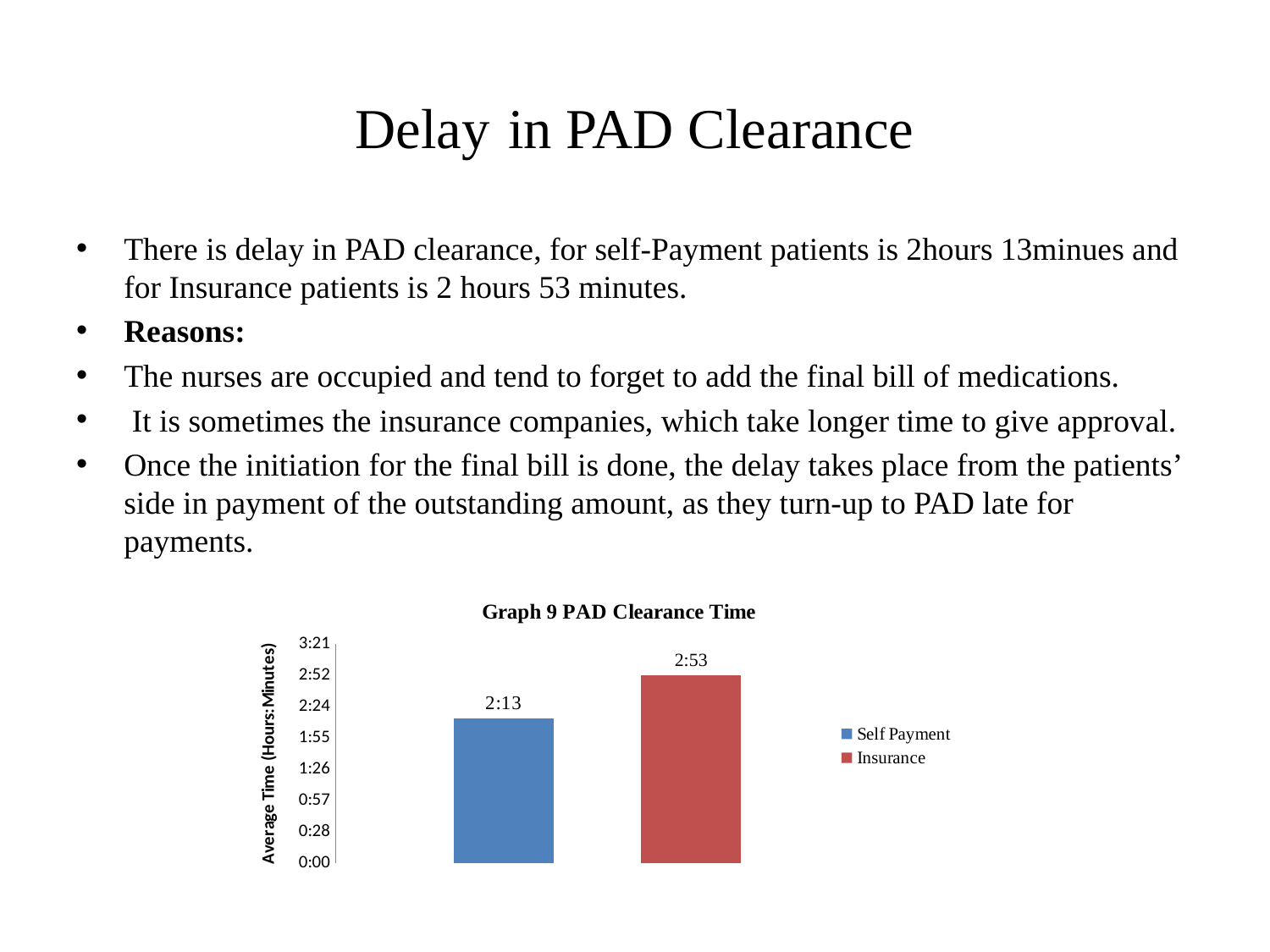
How many bars are plotted in the chart? 2 Is the value for Self Payment greater or less than 2:24? less How many series does the legend list? 2 Which category has the lower average PAD clearance time? Self Payment Which category has the higher average PAD clearance time? Insurance Is the average PAD clearance time for Insurance greater or less than that for Self Payment? greater What is the average PAD clearance time for Self Payment? 2:13 By how many minutes does the Insurance clearance time exceed the Self Payment clearance time? 40 minutes What is the average PAD clearance time for Insurance? 2:53 What kind of chart is shown on the slide? Bar chart What is the title of the chart? Graph 9 PAD Clearance Time Is the value for Insurance greater or less than 2:24? greater